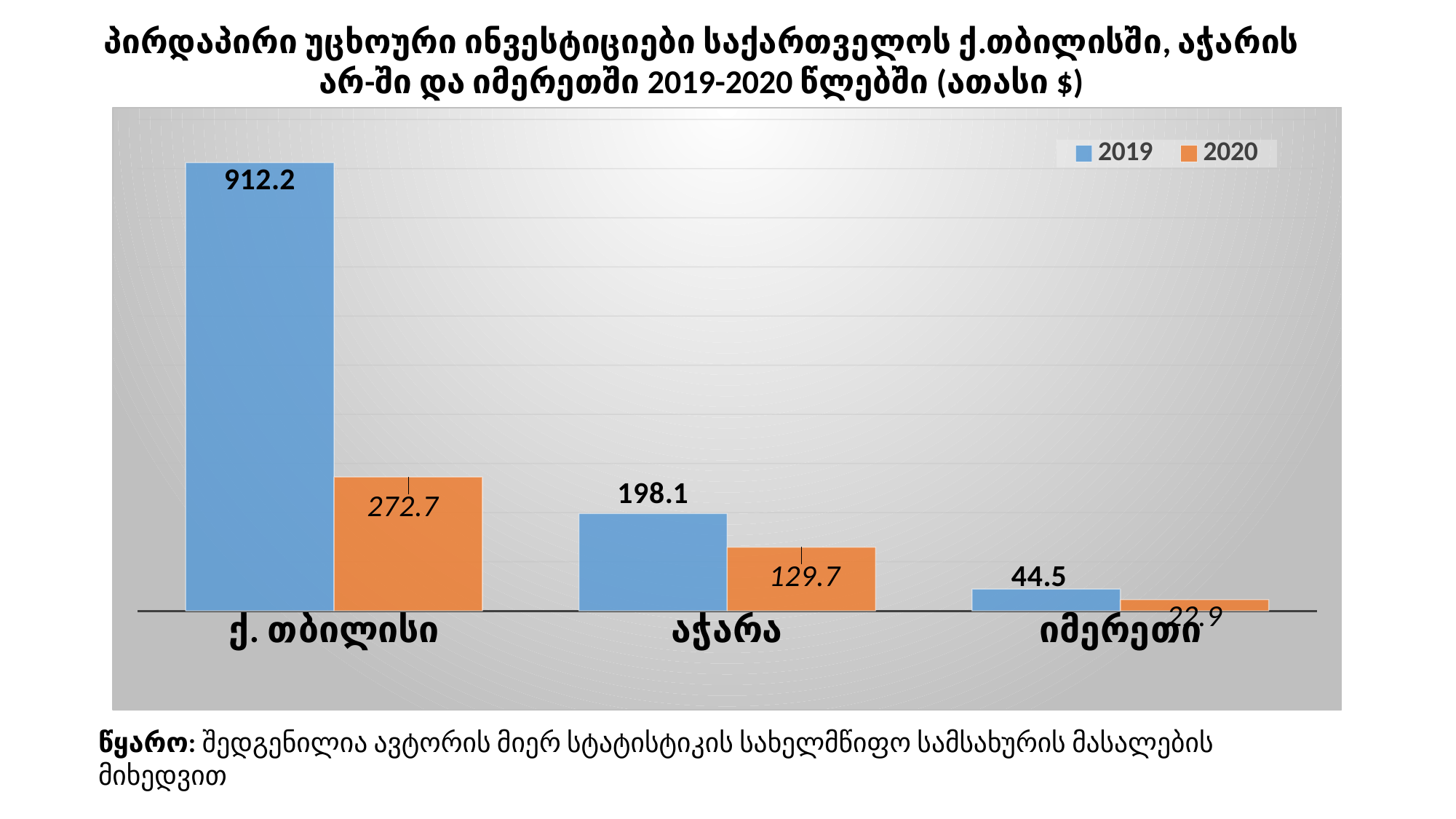
Which is larger: the 2020 value for ქ. თბილისი or the 2019 value for აჭარა? 2020 value for ქ. თბილისი What is the 2019 value for აჭარა? 198.1 What is the difference between the 2019 and 2020 values for ქ. თბილისი? 639.5 Which region has the highest 2019 value? ქ. თბილისი What is the 2019 value for იმერეთი? 44.5 What type of chart is shown on the slide? bar chart Which region has the lowest 2020 value? იმერეთი What is the 2020 value for ქ. თბილისი? 272.7 How many series does the legend list? 2 What is the 2020 value for აჭარა? 129.7 How many categories (regions) are shown on the x axis? 3 What is the 2019 value for ქ. თბილისი? 912.2